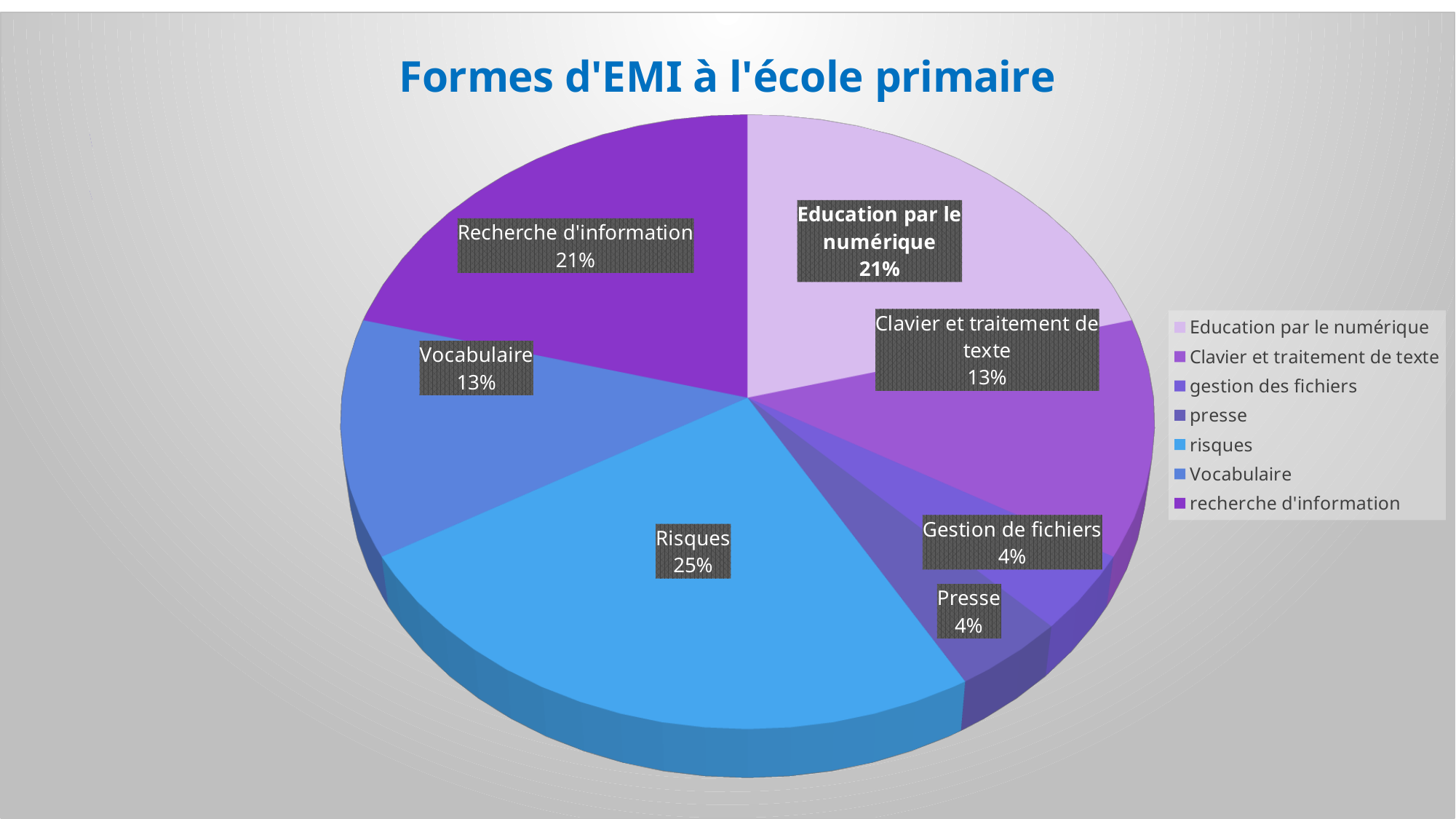
What kind of chart is shown on the slide? pie chart What is the value shown for Recherche d'information? 21% What share of the pie does Risques represent? 25% What is the combined share of Gestion de fichiers and Presse? 8% How many entries does the legend list? 7 What is the value shown for Vocabulaire? 13% What is the title of the chart? Formes d'EMI à l'école primaire Which category has the largest slice of the pie? Risques Which is larger, the share for Education par le numérique or the share for Vocabulaire? Education par le numérique How many slices does the pie chart have? 7 What is the difference between the shares of Risques and Clavier et traitement de texte? 12% What is the value shown for Presse? 4%